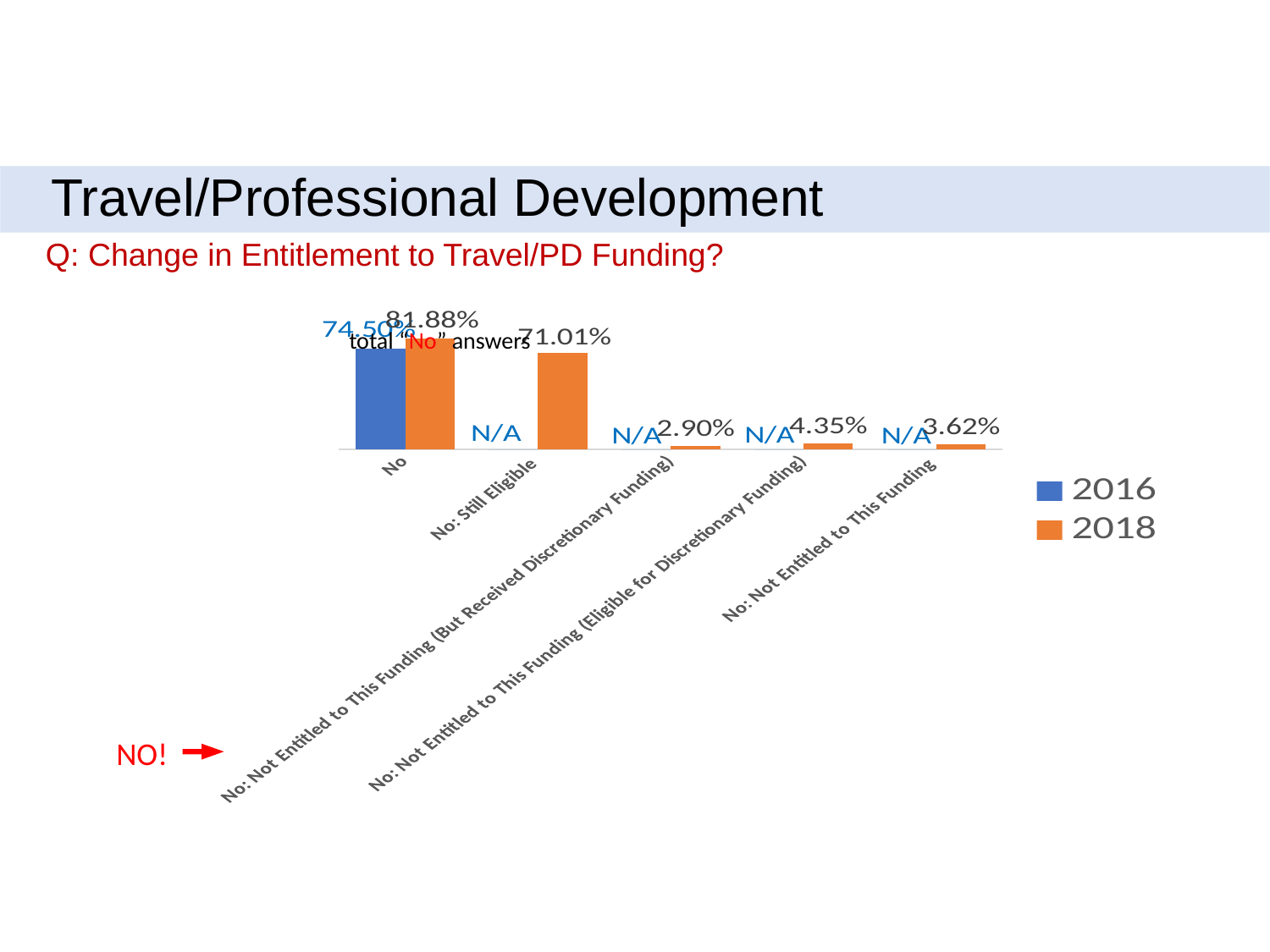
Which category has the lowest 2018 value? No: Not Entitled to This Funding (But Received Discretionary Funding) How many series does the legend list? 2 What is the 2018 value for "No: Not Entitled to This Funding (Eligible for Discretionary Funding)"? 4.35% What is the 2018 value for the "No" category? 81.88% What kind of chart is shown on the slide? Bar chart What is the 2018 value for "No: Not Entitled to This Funding"? 3.62% What is the 2016 value shown for "No: Still Eligible"? N/A What is the 2018 value for "No: Still Eligible"? 71.01% Which category has the highest 2018 value? No What is the 2016 value for the "No" category? 74.50% What is the difference between the 2018 and 2016 values for the "No" category? 7.38% What is the 2018 value for "No: Not Entitled to This Funding (But Received Discretionary Funding)"? 2.90%